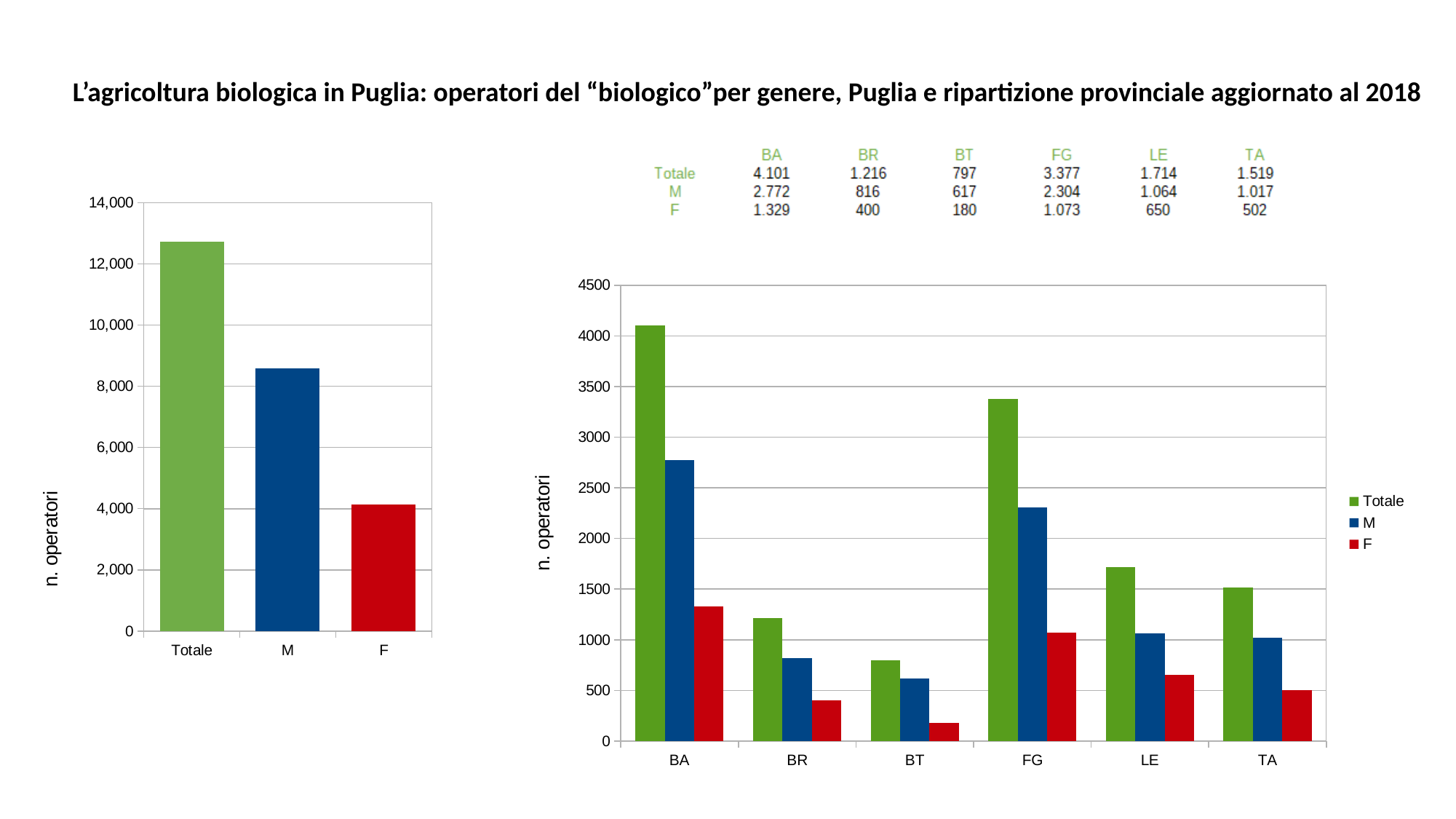
In the left chart, is the value for F greater or less than 6,000? less In the right chart, what is the F value for BT? 180 In the right chart, what is the Totale value for BA? 4.101 In the right chart, what is the difference between the Totale values for BA and FG? 724 In the left chart, is the value for Totale greater or less than 12,000? greater In the left chart, what kind of chart is shown? bar chart In the right chart, which province has the lowest F value? BT In the left chart, how many categories are shown on the x axis? 3 In the right chart, which province has the highest Totale value? BA In the right chart, what is the M value for LE? 1.064 In the left chart, which category has the lowest value? F In the right chart, how many series does the legend list? 3